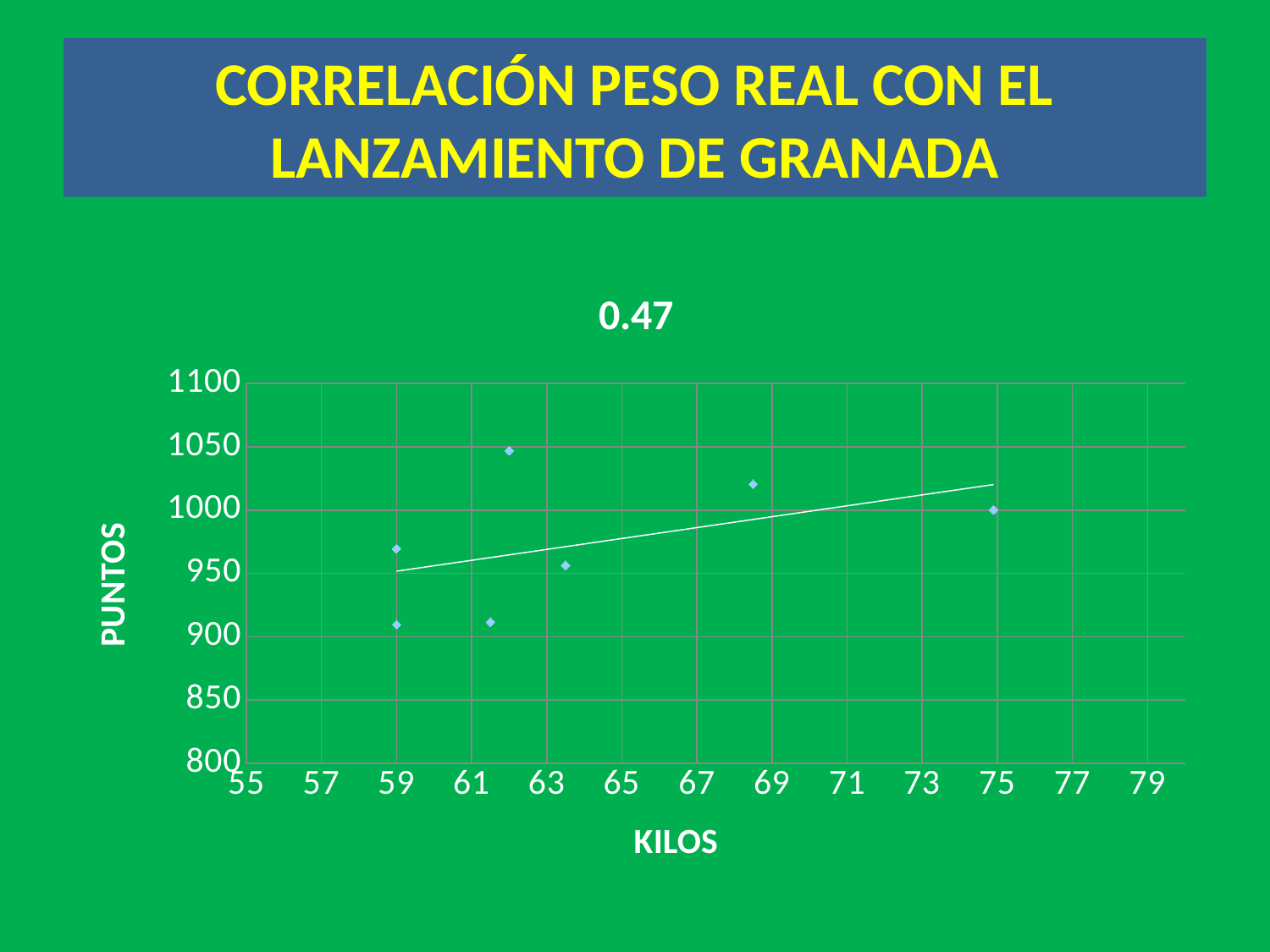
Which has the higher PUNTOS value: the point at about 62 kilos or the point at 75 kilos? the point at about 62 kilos Is the PUNTOS value of the point at 75 kilos greater or less than 1050? less What is the title shown above the chart? 0.47 What kind of chart is shown on the slide? scatter chart Is the highest plotted PUNTOS value greater or less than 1000? greater Is the PUNTOS value of the lowest point at 59 kilos greater or less than 950? less Does the trend line rise or fall as KILOS increases? rises What is the label of the horizontal axis? KILOS How many data points are plotted on the chart? 7